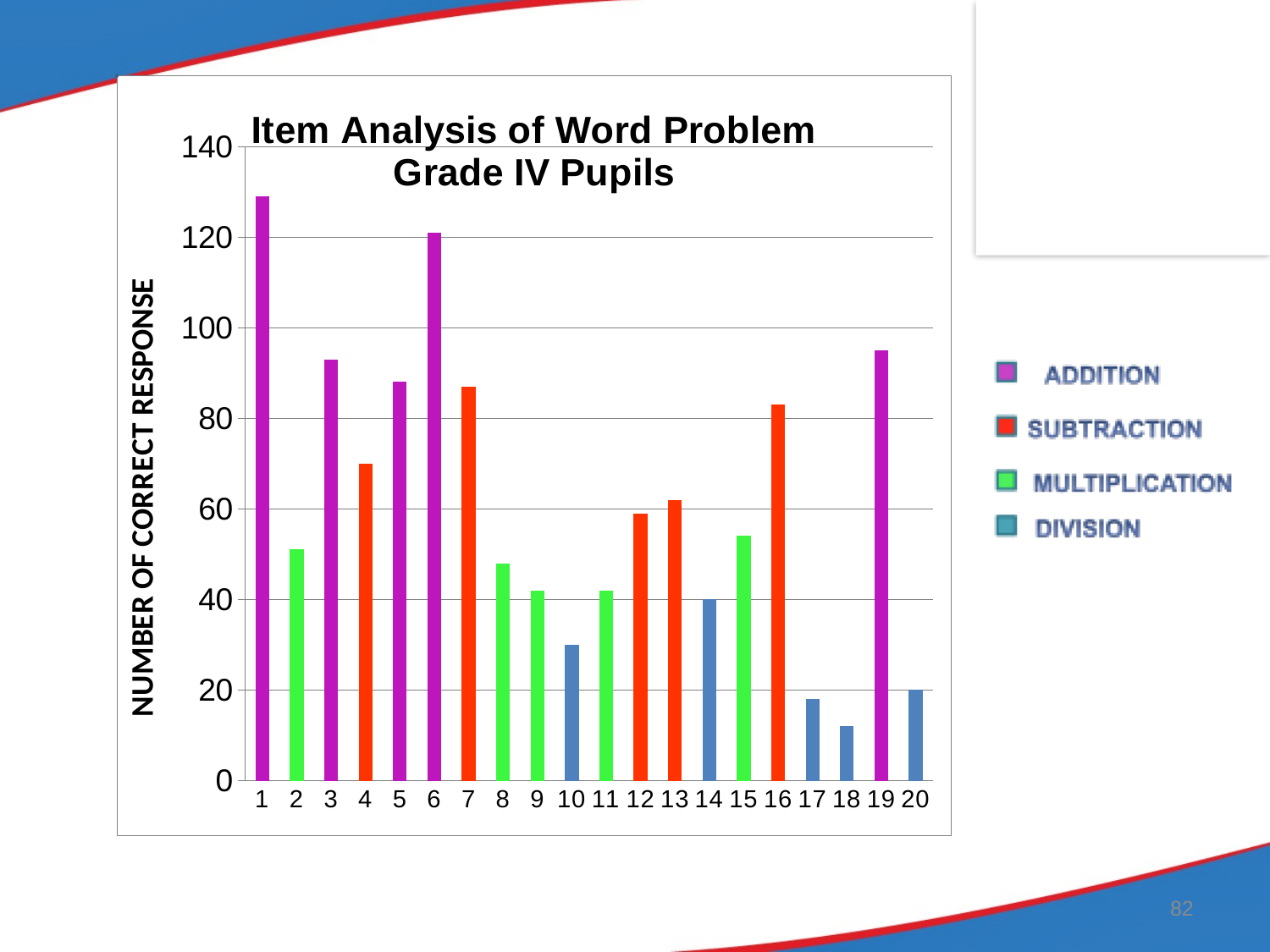
Is the value for item 19 greater or less than 100? less How many items are shown along the x axis? 20 Which item has the lowest number of correct responses? 18 Is the value for item 3 greater or less than 80? greater Is the value for item 1 greater or less than 120? greater Which item has the highest number of correct responses? 1 What is the title of the chart? Item Analysis of Word Problem Grade IV Pupils What kind of chart is shown on the slide? bar chart How many series does the legend list? 4 Which has more correct responses, item 10 or item 14? item 14 What is the label on the vertical axis? NUMBER OF CORRECT RESPONSE